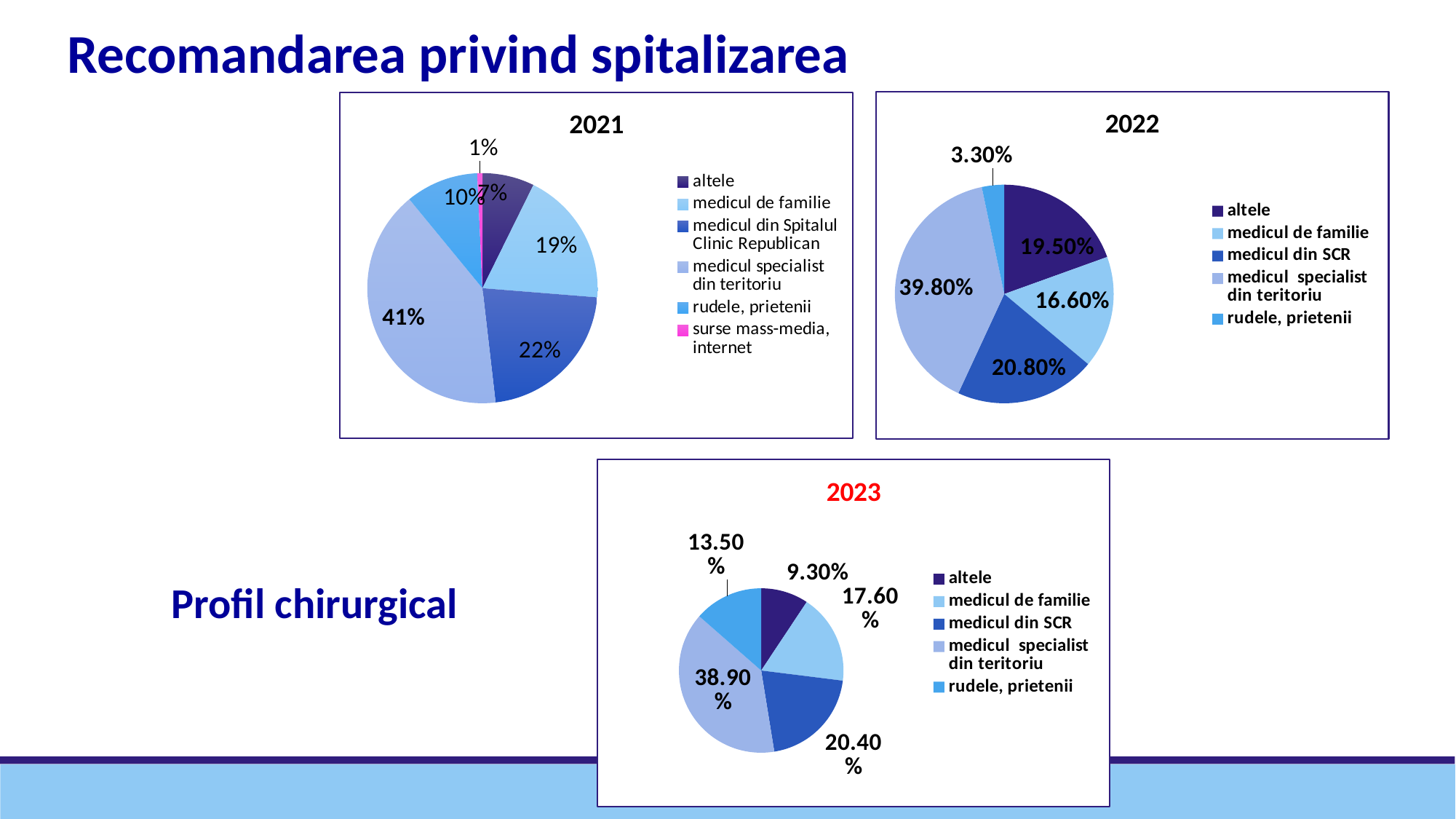
In the 2023 chart, which category has the smallest slice? altele In the 2023 chart, which is larger: the share for medicul din SCR or the share for medicul de familie? medicul din SCR In the 2022 chart, what is the difference between the shares for medicul din SCR and medicul de familie? 4.20% How many categories does the 2022 chart's legend list? 5 How many categories does the 2021 chart's legend list? 6 In the 2022 chart, which category has the largest slice? medicul specialist din teritoriu In the 2023 chart, what share is labelled for rudele, prietenii? 13.50% What kind of chart is the 2023 chart? pie chart In the 2021 chart, what share is labelled for medicul specialist din teritoriu? 41% In the 2021 chart, what share is labelled for surse mass-media, internet? 1% In the 2021 chart, what is the difference between the shares for medicul din Spitalul Clinic Republican and medicul de familie? 3% In the 2022 chart, what share is labelled for altele? 19.50%